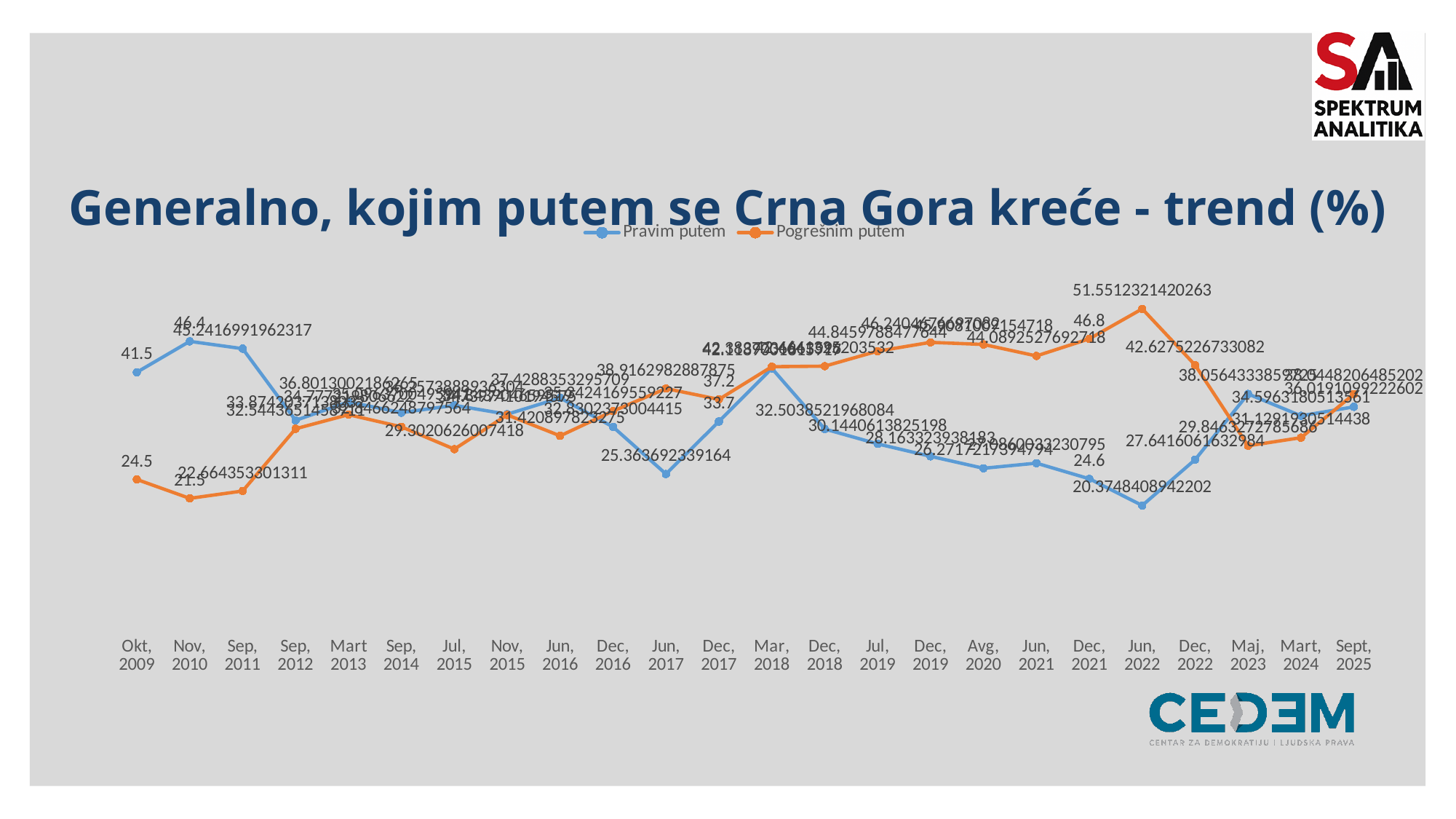
What type of chart is shown on the slide? line chart How many series does the legend list? 2 What is the value for Pravim putem in Nov, 2010? 46.4 At which time point does Pravim putem reach its lowest value? Jun, 2022 What is the value for Pogrešnim putem in Jun, 2022? 51.5512321420263 What is the value for Pogrešnim putem in Dec, 2021? 46.8 What is the difference between Pravim putem and Pogrešnim putem in Okt, 2009? 17 How many time points are shown on the x axis? 24 What is the value for Pravim putem in Okt, 2009? 41.5 What is the value for Pogrešnim putem in Okt, 2009? 24.5 In Dec, 2021, which series has the larger value, Pravim putem or Pogrešnim putem? Pogrešnim putem At which time point does Pogrešnim putem reach its highest value? Jun, 2022